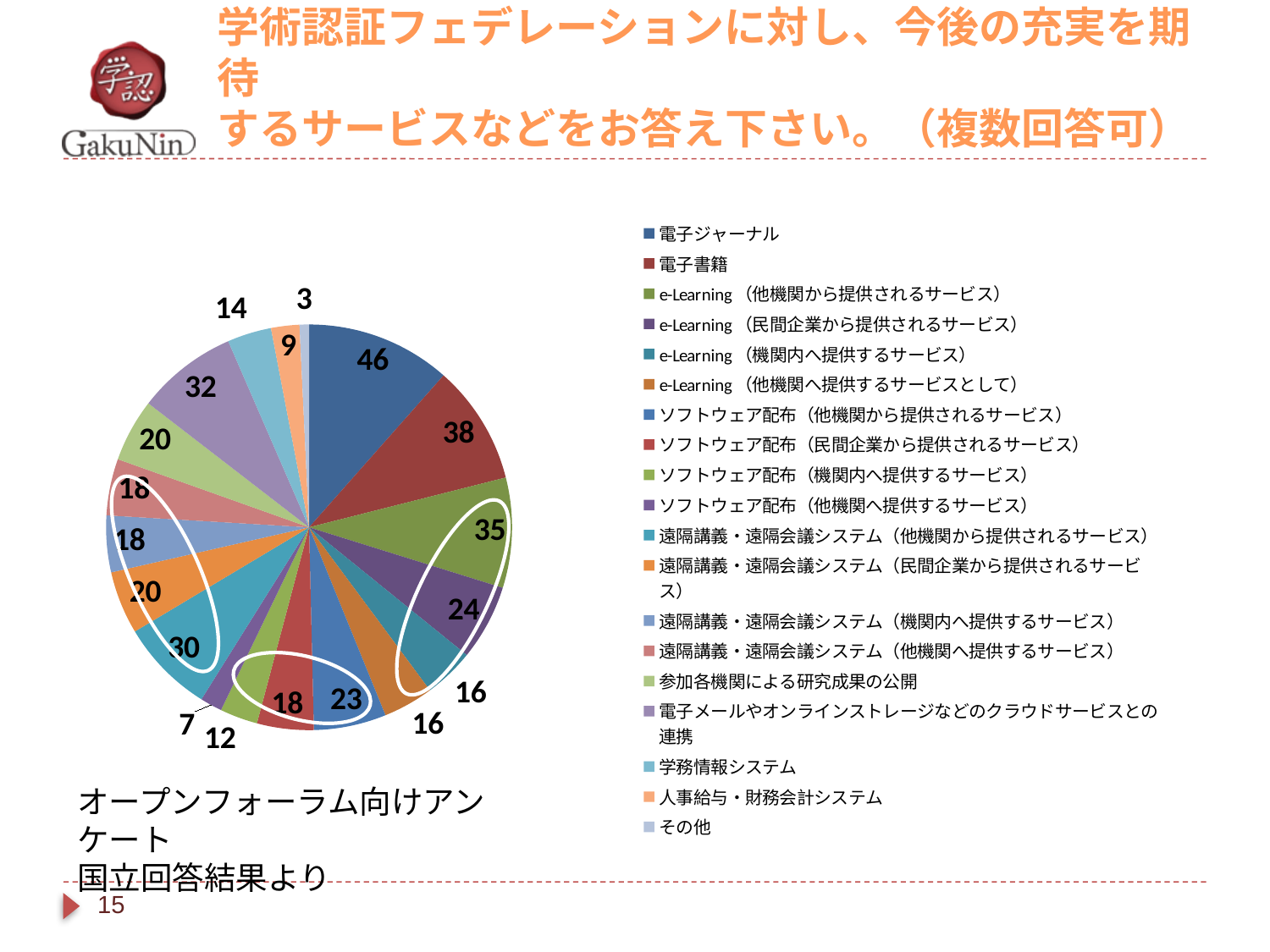
What is the value for 学務情報システム in the pie chart? 14 What is the value for 電子ジャーナル in the pie chart? 46 Which is larger, the value for 電子ジャーナル or the value for 電子書籍? 電子ジャーナル What is the value for 電子書籍 in the pie chart? 38 How many categories does the legend of the pie chart list? 19 Which category has the smallest slice in the pie chart? その他 What is the value for 電子メールやオンラインストレージなどのクラウドサービスとの連携 in the pie chart? 32 What kind of chart is shown on the slide? pie chart What is the difference between the values for 電子ジャーナル and 電子書籍? 8 What is the value for その他 in the pie chart? 3 Which category has the largest slice in the pie chart? 電子ジャーナル What is the value for 人事給与・財務会計システム in the pie chart? 9